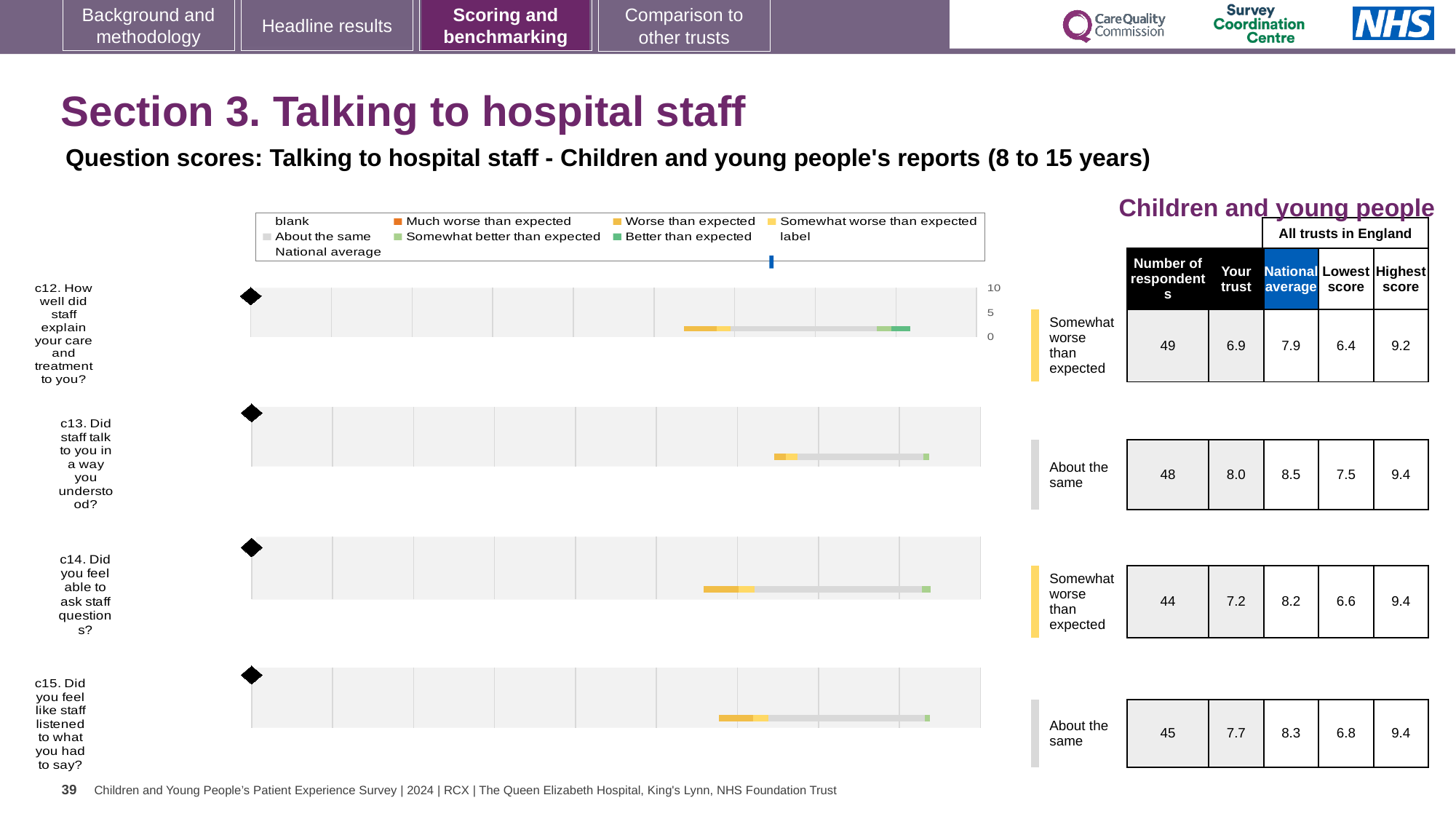
For question c15 (Did you feel like staff listened to what you had to say?), what is the highest score among all trusts in England? 9.4 For question c13 (Did staff talk to you in a way you understood?), what is the national average score? 8.5 Which of the four questions (c12 to c15) has the highest 'Your trust' score? c13 For question c14, what is the difference between the national average and the 'Your trust' score? 1.0 Which of the four questions (c12 to c15) has the lowest 'Your trust' score? c12 Is the 'Your trust' score higher for question c12 or for question c15? c15 How many questions are charted on this slide? 4 How many respondents answered question c14 (Did you feel able to ask staff questions?)? 44 For question c12, what is the lowest score among all trusts in England? 6.4 What benchmark category is shown for question c14 (Did you feel able to ask staff questions?)? Somewhat worse than expected What kind of chart is used to show the question scores on this slide? Bar chart For question c12 (How well did staff explain your care and treatment to you?), what is the 'Your trust' score? 6.9